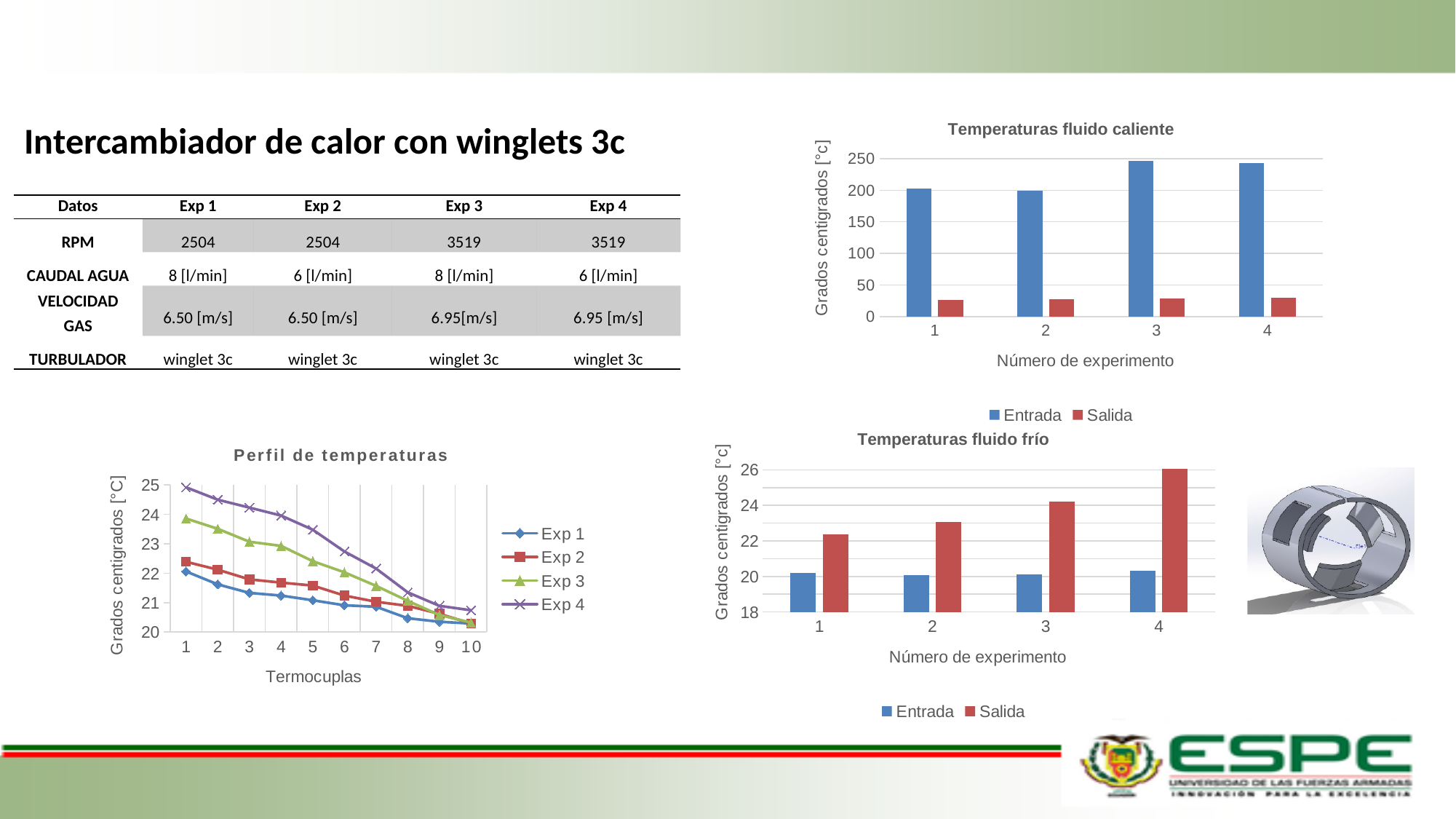
What kind of chart is "Perfil de temperaturas"? line chart In the "Temperaturas fluido frío" chart, do the Salida values rise or fall from experiment 1 to experiment 4? rise In the "Perfil de temperaturas" chart, how many thermocouple points are shown on the x axis? 10 In the "Temperaturas fluido frío" chart, which experiment has the lowest Salida value? 1 In the "Temperaturas fluido caliente" chart, which is larger for experiment 2, Entrada or Salida? Entrada In the "Temperaturas fluido caliente" chart, how many series does the legend list? 2 In the "Temperaturas fluido frío" chart, which experiment has the highest Salida value? 4 In the "Temperaturas fluido caliente" chart, is the Salida value for experiment 1 greater or less than 50? less In the "Temperaturas fluido caliente" chart, is the Entrada value for experiment 1 greater or less than 150? greater In the "Perfil de temperaturas" chart, how many series does the legend list? 4 What kind of chart is "Temperaturas fluido caliente"? bar chart In the "Perfil de temperaturas" chart, is the Exp 4 value at thermocouple 1 greater or less than 24? greater